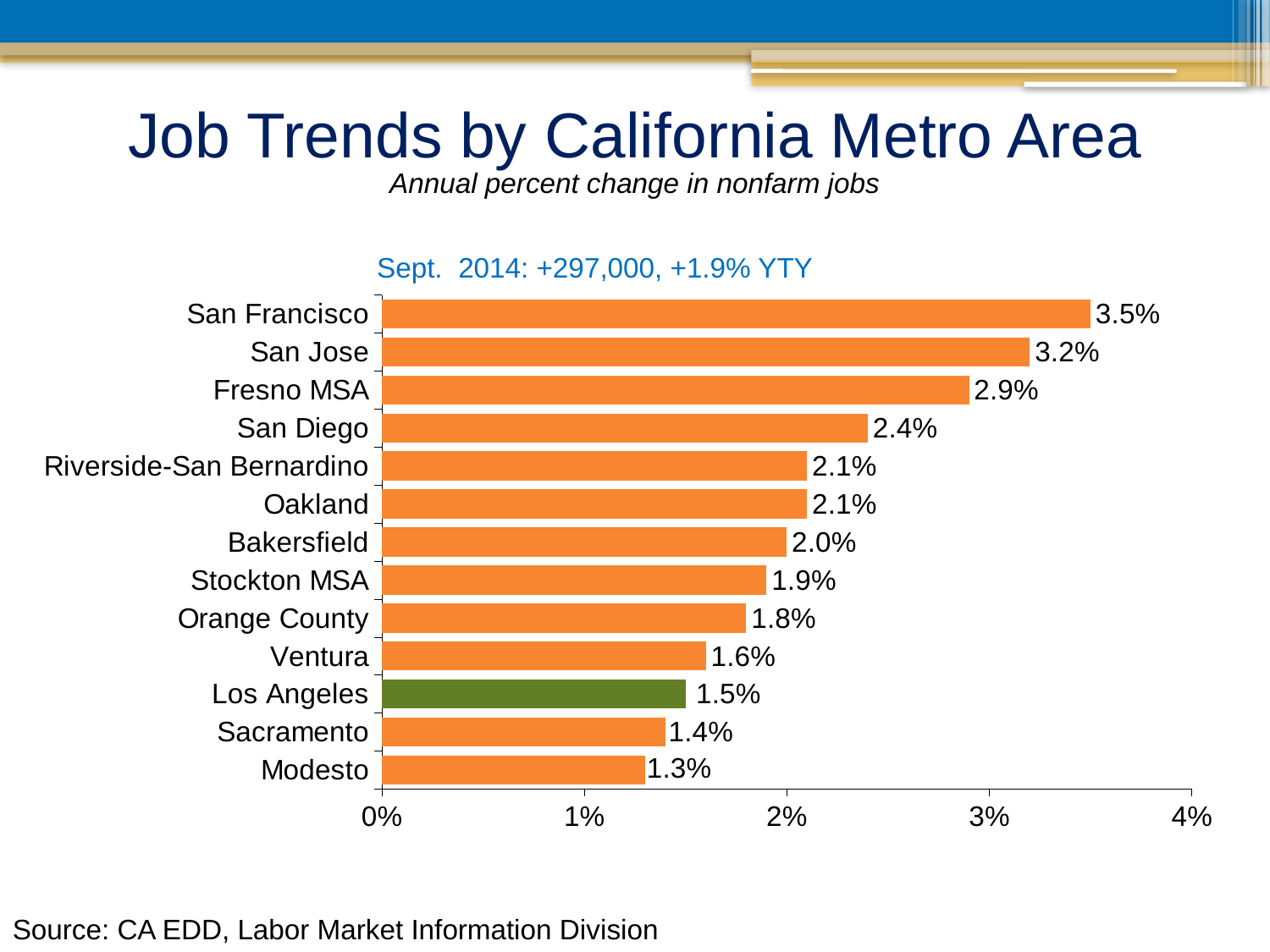
What kind of chart is shown on the slide? Bar chart What is the annual percent change in nonfarm jobs for San Francisco? 3.5% Which metro area has the lowest annual percent change in nonfarm jobs? Modesto Which metro area has the highest annual percent change in nonfarm jobs? San Francisco What is the value shown for Los Angeles? 1.5% What is the difference between the values for San Francisco and Modesto? 2.2% Which metro area's bar is shown in green rather than orange? Los Angeles What is the value shown for Fresno MSA? 2.9% How many metro areas are shown in the chart? 13 Is the value for Bakersfield greater or less than 1%? greater Which has a larger value, Orange County or Ventura? Orange County What is the difference between the values for San Jose and San Diego? 0.8%